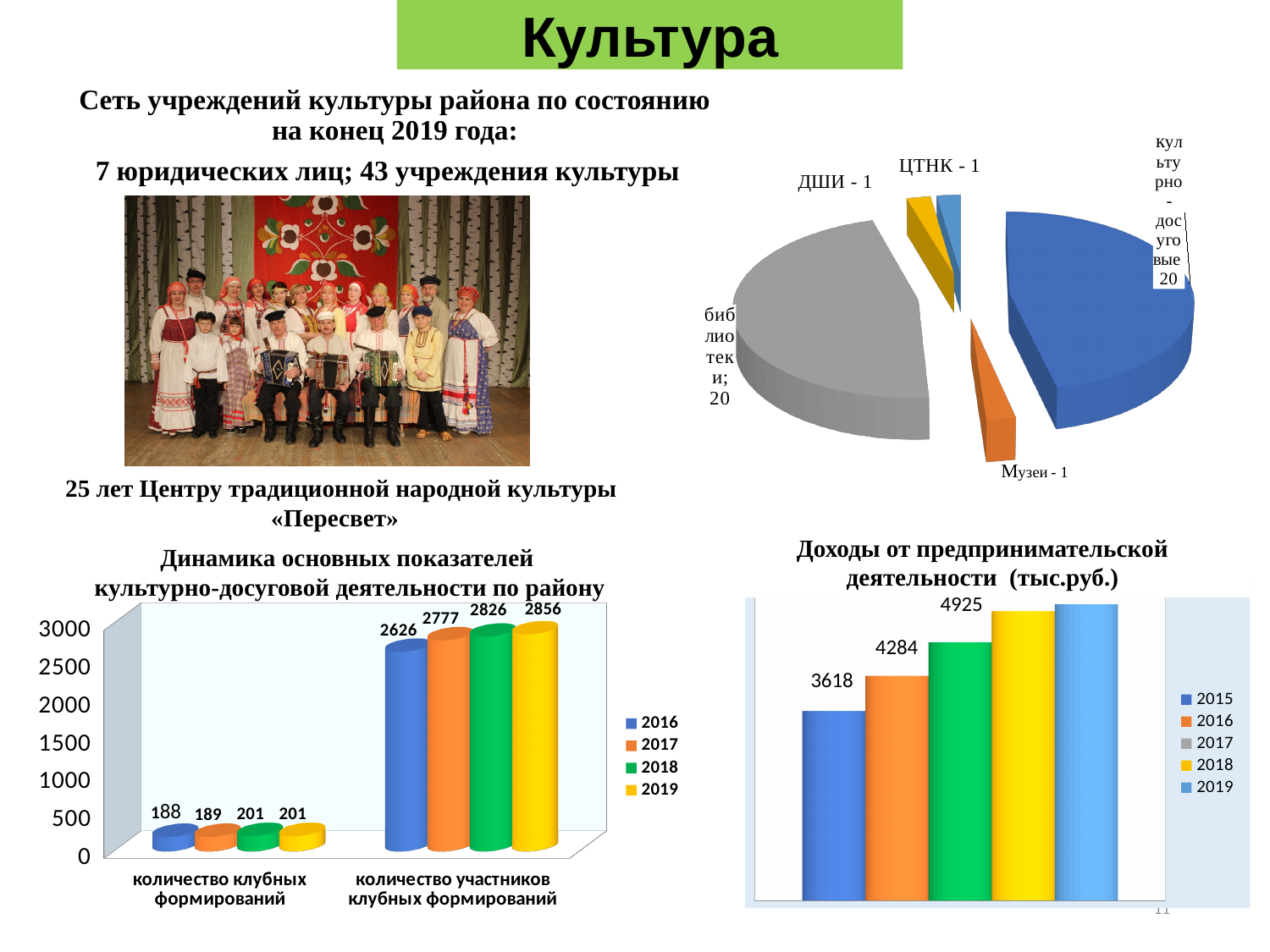
In the chart 'Динамика основных показателей культурно-досуговой деятельности по району', what is the difference between the 2019 and 2016 values for 'количество участников клубных формирований'? 230 In the chart 'Доходы от предпринимательской деятельности (тыс.руб.)', which year has the highest value? 2019 In the chart 'Динамика основных показателей культурно-досуговой деятельности по району', what is the value for 'количество участников клубных формирований' in 2019? 2856 In the pie chart at the top right, how many slices does the pie have? 5 In the chart 'Динамика основных показателей культурно-досуговой деятельности по району', what is the value for 'количество клубных формирований' in 2016? 188 In the pie chart at the top right, how many institutions are in the 'библиотеки' slice? 20 In the chart 'Динамика основных показателей культурно-досуговой деятельности по району', how many series does the legend list? 4 What kind of chart is 'Доходы от предпринимательской деятельности (тыс.руб.)'? bar chart In the chart 'Доходы от предпринимательской деятельности (тыс.руб.)', what is the difference between the 2016 and 2015 values? 666 In the chart 'Доходы от предпринимательской деятельности (тыс.руб.)', what is the value for 2015? 3618 In the pie chart at the top right, what share of the 43 institutions do the 'библиотеки' (20) represent? 20/43 In the chart 'Динамика основных показателей культурно-досуговой деятельности по району', do the values for 'количество участников клубных формирований' rise or fall from 2016 to 2019? rise